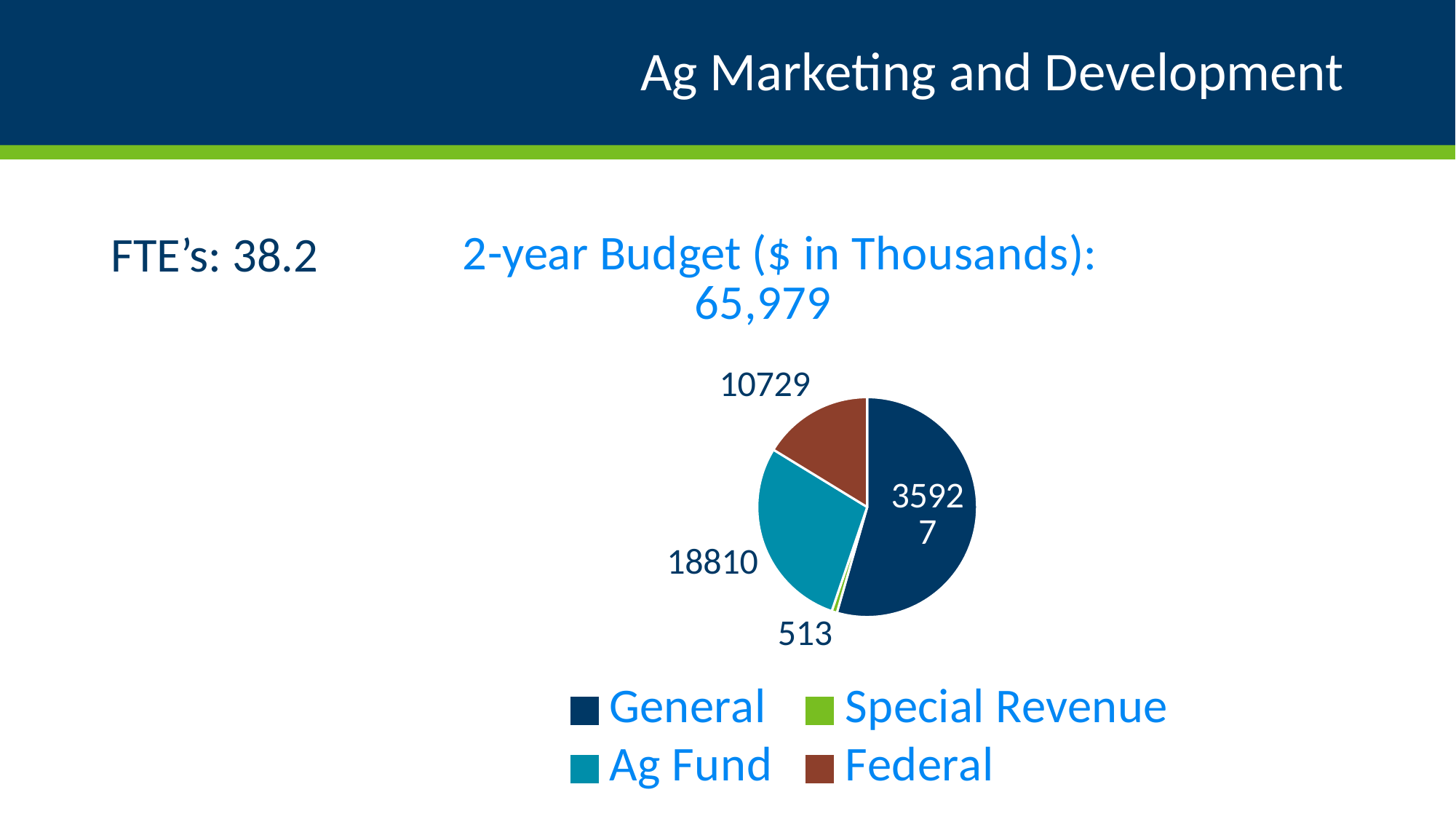
Which category has the largest slice of the pie chart? General What is the difference between the Ag Fund and Federal values? 8081 What is the title of the chart? 2-year Budget ($ in Thousands): 65,979 Which is larger, Ag Fund or Federal? Ag Fund How many categories does the pie chart show? 4 What is the value for Special Revenue in the pie chart? 513 What kind of chart is shown on the slide? Pie chart What is the value for General in the pie chart? 35927 What is the value for Ag Fund in the pie chart? 18810 What is the value for Federal in the pie chart? 10729 What is the difference between the General and Ag Fund values? 17117 Which category has the smallest slice of the pie chart? Special Revenue